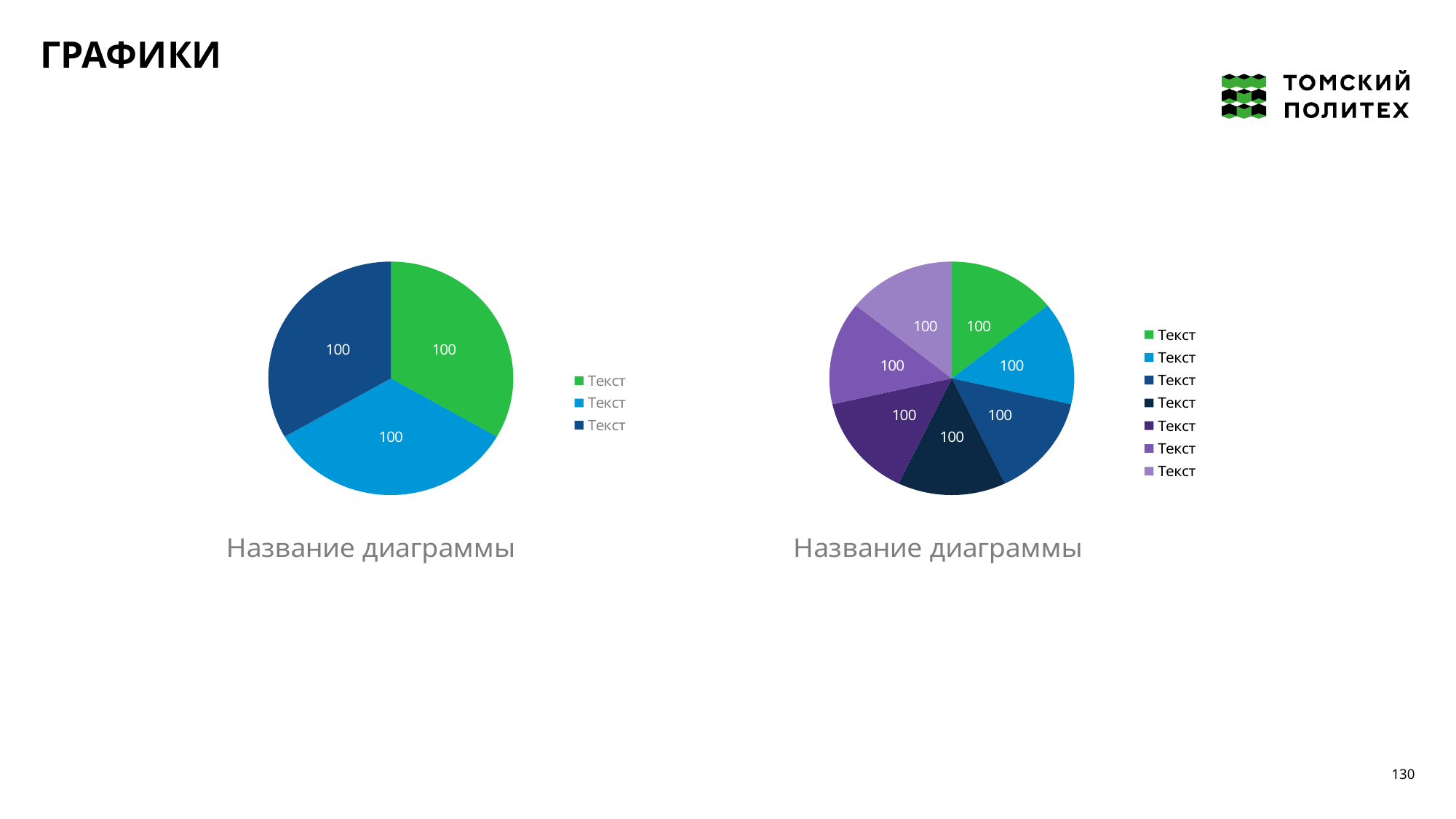
How many slices does the pie chart on the left have? 3 How many entries does the legend of the left pie chart list? 3 How many entries does the legend of the right pie chart list? 7 What kind of chart is the chart on the right of the slide? pie chart In the pie chart on the right, what value is shown on the light purple slice? 100 What is the total of all slice values in the pie chart on the left? 300 What is the title shown under each of the two pie charts? Название диаграммы In the pie chart on the left, what value is shown on the green slice? 100 What kind of chart is the chart on the left of the slide? pie chart How many slices does the pie chart on the right have? 7 What is the total of all slice values in the pie chart on the right? 700 In the pie chart on the left, is the green slice larger than, smaller than, or equal to the light blue slice? equal